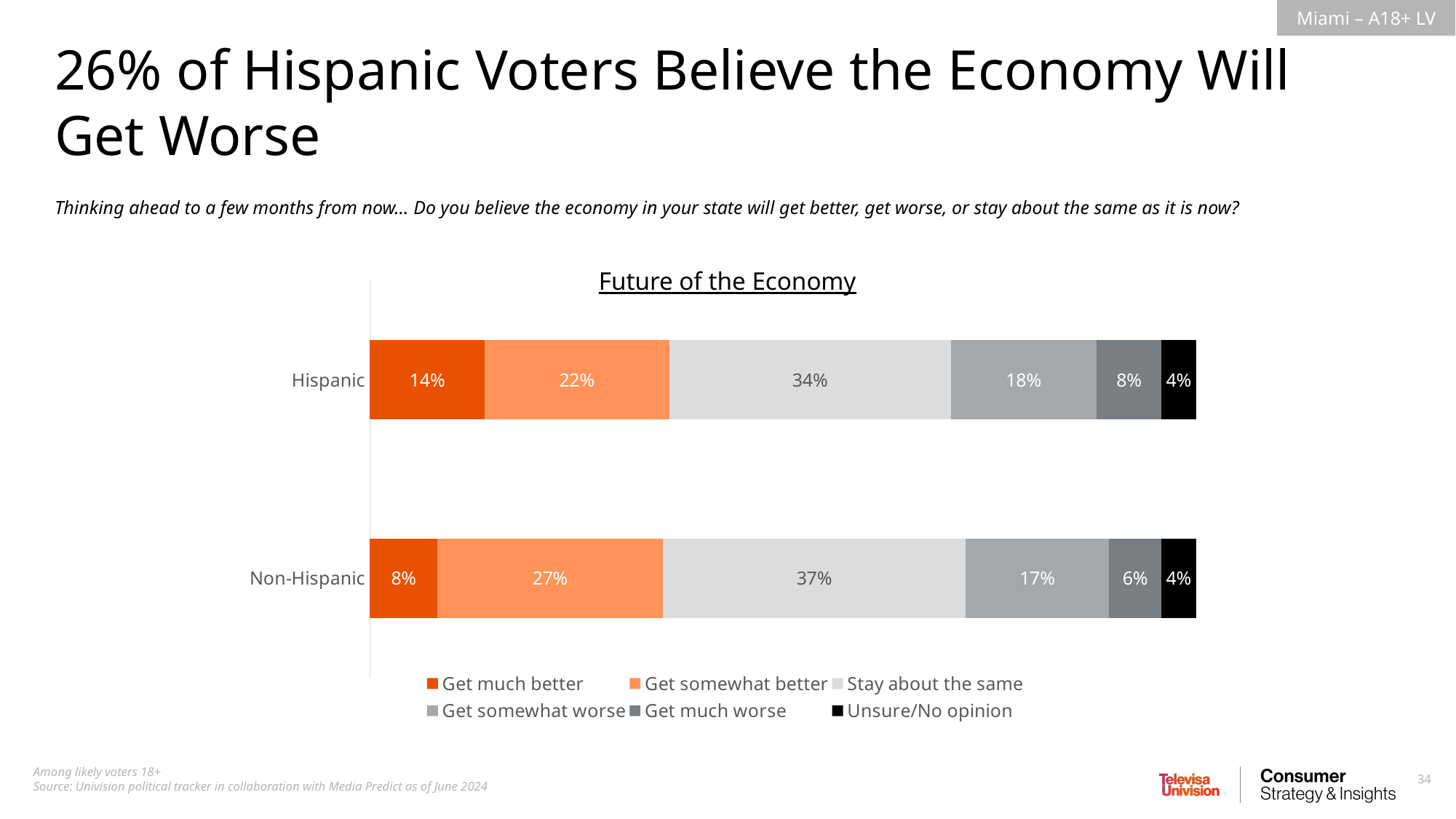
What is the title of the chart? Future of the Economy What is the difference between the Hispanic and Non-Hispanic shares for 'Get much better'? 6 percentage points Which response has the largest share among Non-Hispanic voters? Stay about the same How many groups (bars) are shown in the chart? 2 What type of chart is shown on the slide? Stacked bar chart How many series does the legend list? 6 What percentage of Non-Hispanic voters say the economy will get somewhat better? 27% Which response has the smallest share among Hispanic voters? Unsure/No opinion What percentage of Hispanic voters say the economy will get somewhat worse? 18% What percentage of Hispanic voters say the economy will stay about the same? 34% Which group has a larger share saying the economy will get much worse, Hispanic or Non-Hispanic? Hispanic What percentage of Non-Hispanic voters say the economy will get much better? 8%